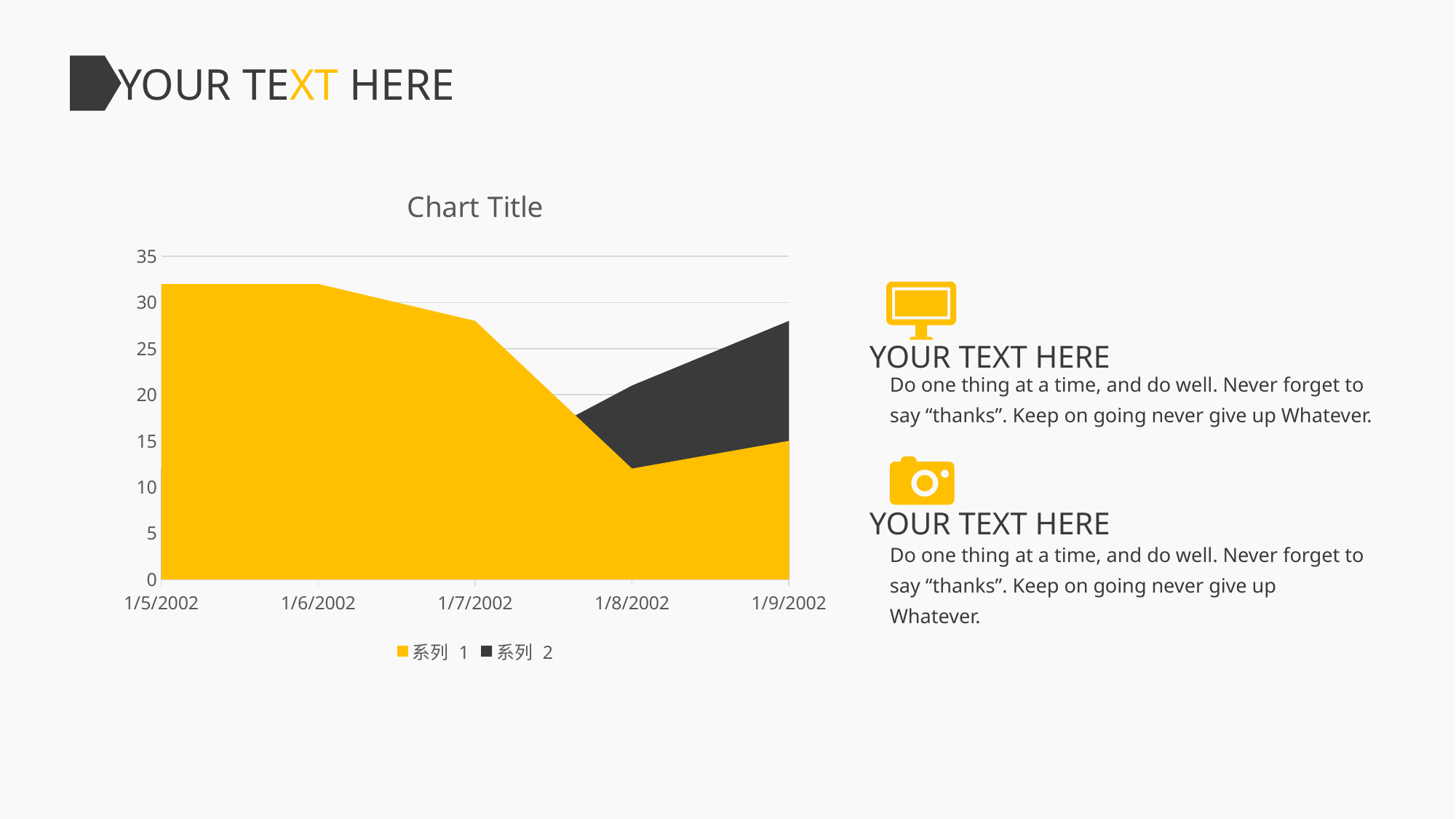
Is the value of 系列 1 at 1/8/2002 greater or less than 15? less At which date does 系列 1 reach its lowest value? 1/8/2002 Is the value of 系列 1 at 1/5/2002 greater or less than 30? greater What kind of chart is shown on the slide? Area chart What is the title of the chart? Chart Title Is the value of 系列 2 at 1/9/2002 greater or less than 25? greater How many dates are shown on the x axis of the chart? 5 At 1/9/2002, which series has the larger value, 系列 1 or 系列 2? 系列 2 Which colour represents 系列 2 in the chart? Dark grey Does the value of 系列 1 rise or fall from 1/6/2002 to 1/8/2002? fall How many series does the chart legend list? 2